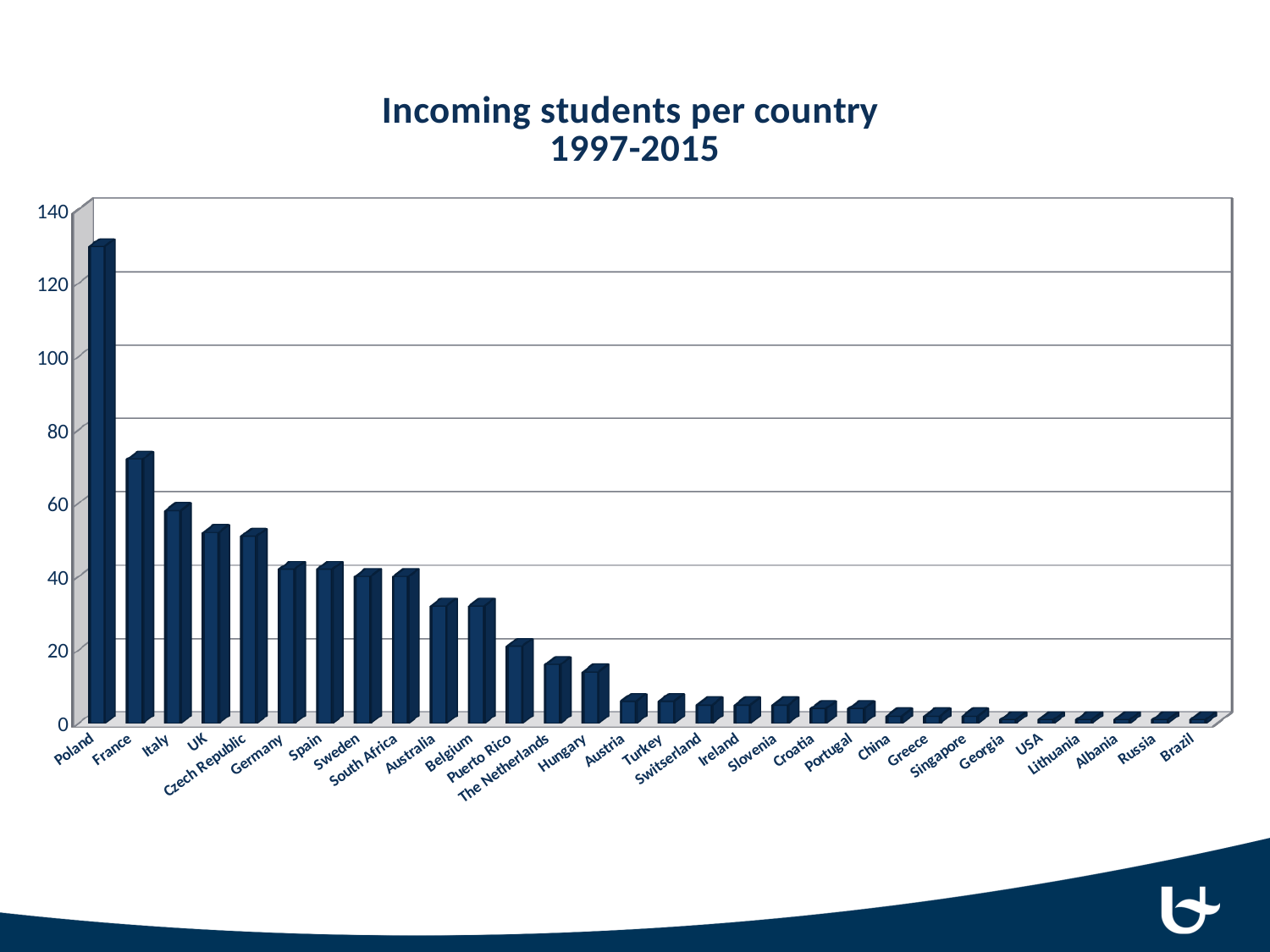
What is the title of the chart? Incoming students per country 1997-2015 Do the values generally rise or fall moving from left to right along the x axis? fall Is the value for UK greater or less than 40? greater Is the value for Poland greater or less than 120? greater How many countries are shown on the x axis of the chart? 30 Which country has the highest number of incoming students? Poland What kind of chart is shown on the slide? bar chart Is the value for Australia greater or less than 20? greater Which has more incoming students, Italy or UK? Italy